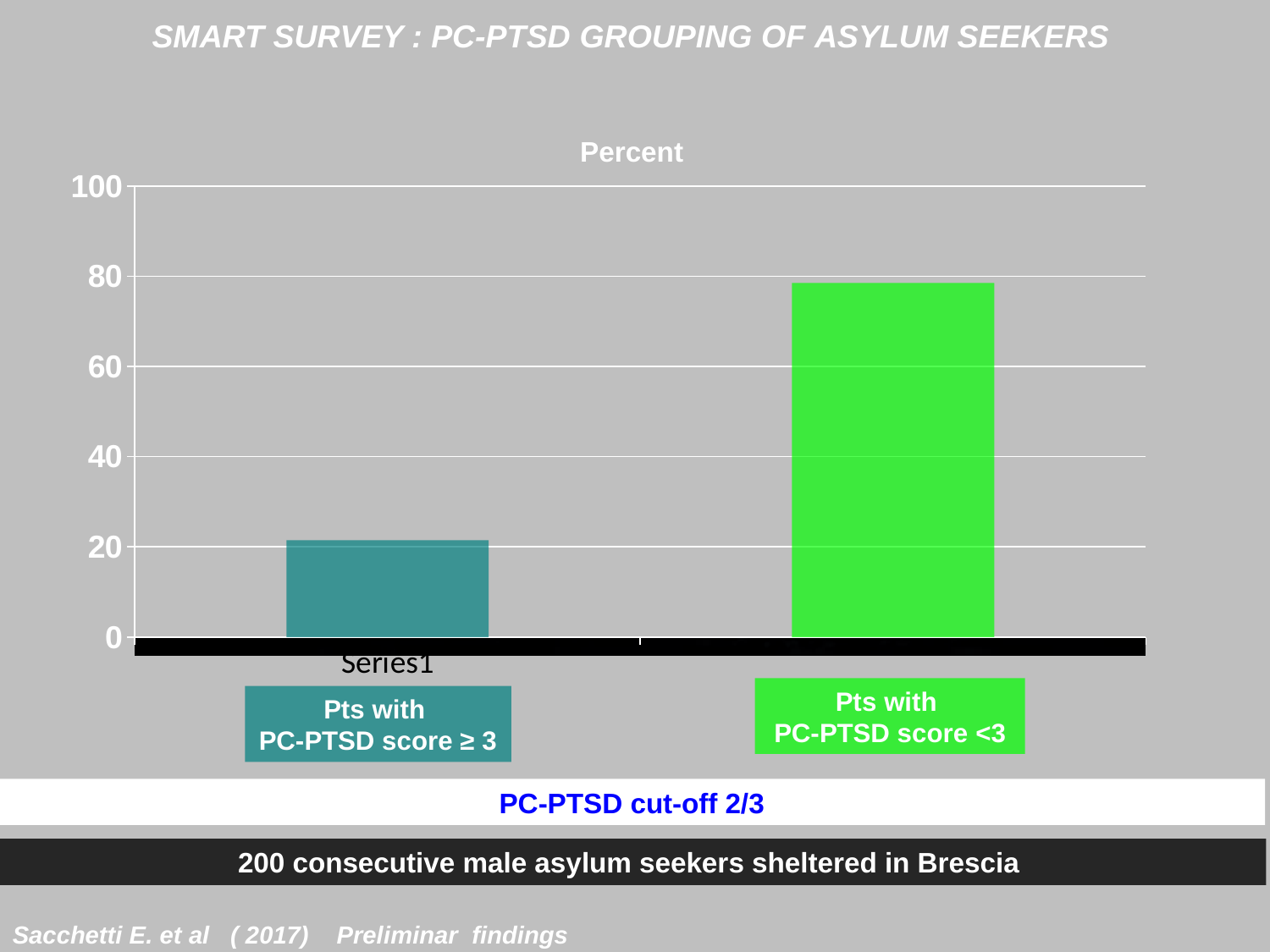
What is the highest value shown on the vertical axis of the chart? 100 Is the value for Pts with PC-PTSD score <3 greater or less than 60? greater Is the bar for Pts with PC-PTSD score ≥ 3 larger or smaller than the bar for Pts with PC-PTSD score <3? smaller Which group has the lower bar in the chart? Pts with PC-PTSD score ≥ 3 What kind of chart is shown on the slide? bar chart What colour is the bar for Pts with PC-PTSD score <3? green Is the value for Pts with PC-PTSD score <3 greater or less than 100? less Which group has the higher bar in the chart? Pts with PC-PTSD score <3 What is the title shown above the chart? Percent How many bars are plotted in the chart? 2 Is the value for Pts with PC-PTSD score ≥ 3 greater or less than 40? less